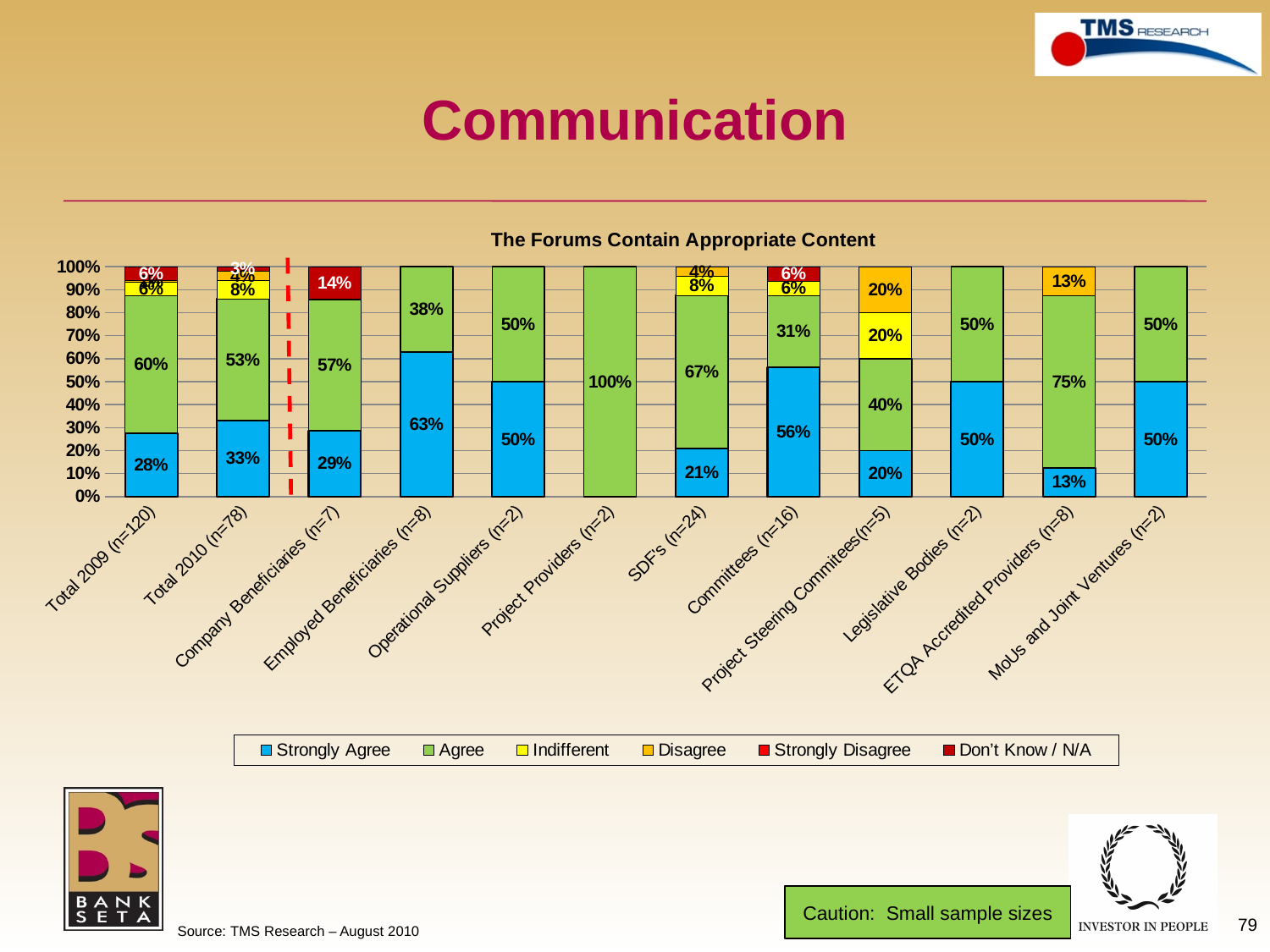
How many respondent categories are shown along the x axis? 12 By how many percentage points does the Strongly Agree value for Total 2010 (n=78) exceed that for Total 2009 (n=120)? 5 percentage points What is the Strongly Agree value for Employed Beneficiaries (n=8)? 63% What is the Agree value for Project Providers (n=2)? 100% Which category has the highest Strongly Agree value? Employed Beneficiaries (n=8) What is the title of the chart? The Forums Contain Appropriate Content What is the Indifferent value for Project Steering Committees (n=5)? 20% How many series does the legend list? 6 What kind of chart is shown on the slide? Stacked bar chart Which category has the lowest Agree value? Committees (n=16) Which has the larger Agree value, ETQA Accredited Providers (n=8) or SDF's (n=24)? ETQA Accredited Providers (n=8) What is the Strongly Agree value for Total 2009 (n=120)? 28%